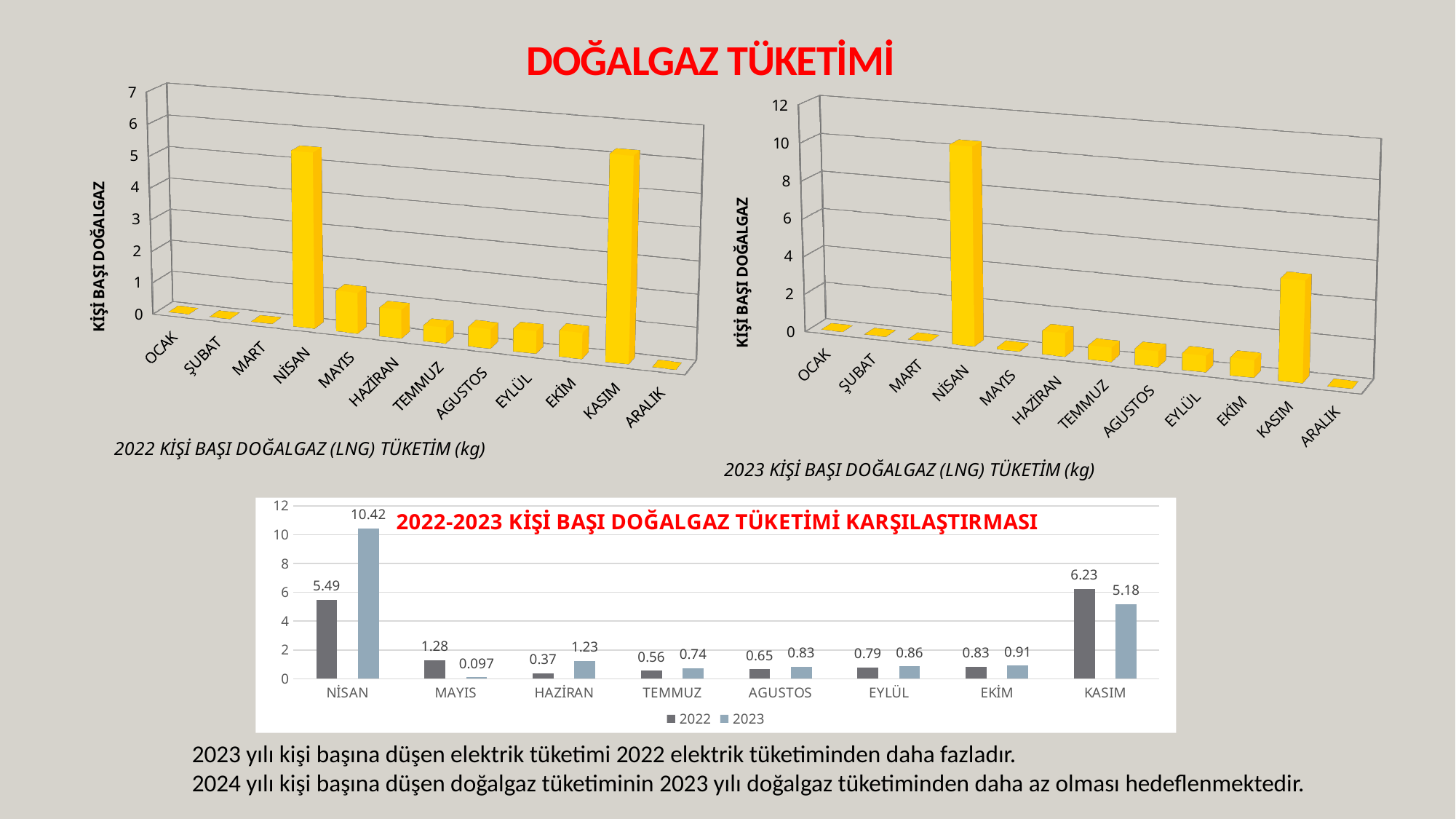
In the bottom chart '2022-2023 KİŞİ BAŞI DOĞALGAZ TÜKETİMİ KARŞILAŞTIRMASI', which month has the highest 2022 value? KASIM In the bottom chart '2022-2023 KİŞİ BAŞI DOĞALGAZ TÜKETİMİ KARŞILAŞTIRMASI', what is the 2023 value for MAYIS? 0.097 In the top-right chart '2023 KİŞİ BAŞI DOĞALGAZ (LNG) TÜKETİM (kg)', is the value for KASIM greater or less than 8? less In the bottom chart '2022-2023 KİŞİ BAŞI DOĞALGAZ TÜKETİMİ KARŞILAŞTIRMASI', what is the 2023 value for NİSAN? 10.42 In the top-left chart '2022 KİŞİ BAŞI DOĞALGAZ (LNG) TÜKETİM (kg)', is the value for NİSAN greater or less than 4? greater In the bottom chart '2022-2023 KİŞİ BAŞI DOĞALGAZ TÜKETİMİ KARŞILAŞTIRMASI', how many series does the legend list? 2 In the bottom chart '2022-2023 KİŞİ BAŞI DOĞALGAZ TÜKETİMİ KARŞILAŞTIRMASI', what is the 2022 value for KASIM? 6.23 In the bottom chart '2022-2023 KİŞİ BAŞI DOĞALGAZ TÜKETİMİ KARŞILAŞTIRMASI', which is larger for KASIM, the 2022 value or the 2023 value? 2022 What kind of chart is the top-right chart '2023 KİŞİ BAŞI DOĞALGAZ (LNG) TÜKETİM (kg)'? bar chart In the bottom chart '2022-2023 KİŞİ BAŞI DOĞALGAZ TÜKETİMİ KARŞILAŞTIRMASI', what is the difference between the 2023 and 2022 values for NİSAN? 4.93 In the bottom chart '2022-2023 KİŞİ BAŞI DOĞALGAZ TÜKETİMİ KARŞILAŞTIRMASI', which month has the lowest 2023 value? MAYIS In the bottom chart '2022-2023 KİŞİ BAŞI DOĞALGAZ TÜKETİMİ KARŞILAŞTIRMASI', how many months are shown on the x axis? 8